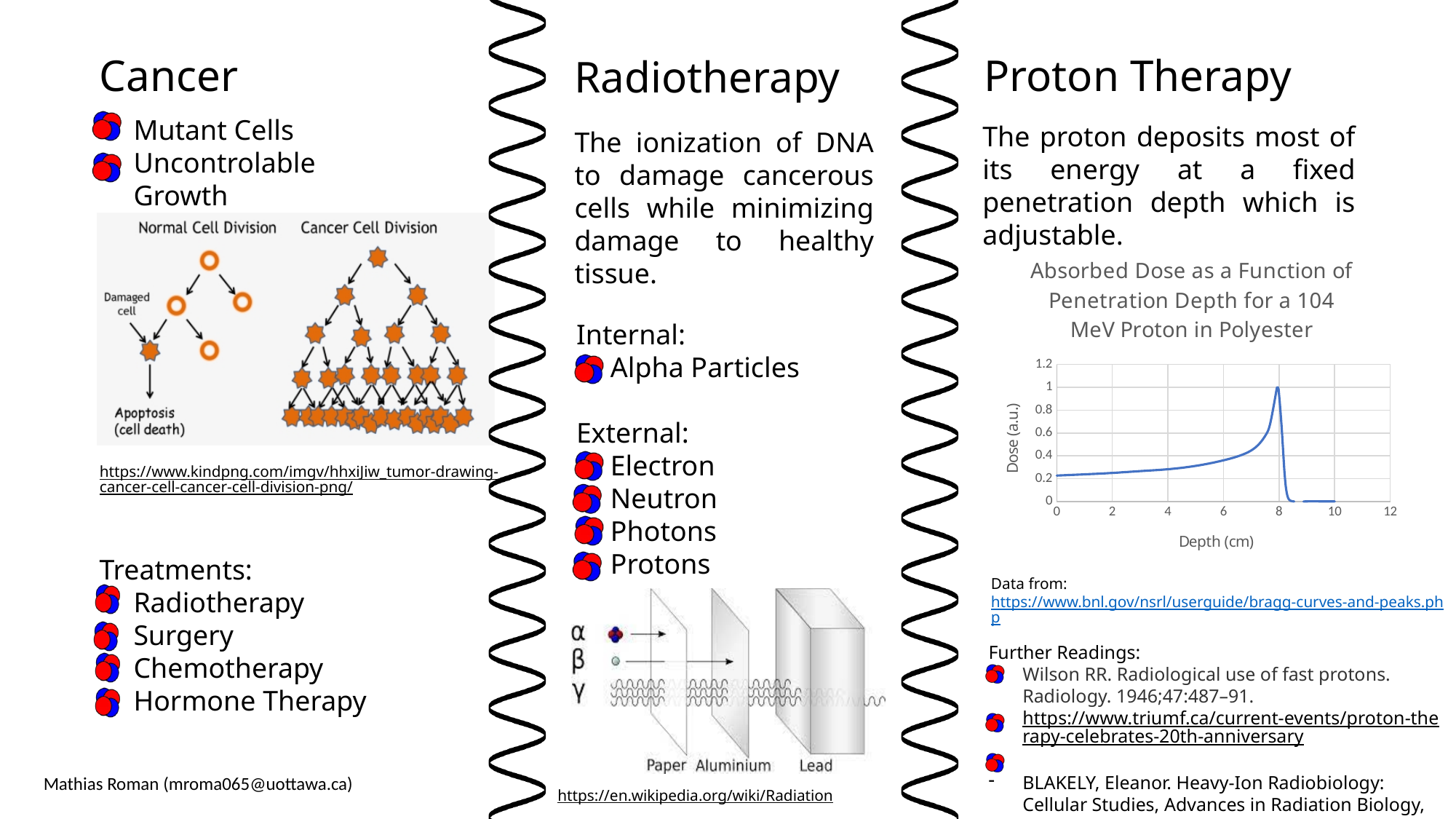
Is the dose at a depth of 10 cm greater or less than 0.2? less What is the highest value shown on the y axis of the chart? 1.2 Does the dose rise or fall as depth increases from 0 cm to 8 cm? rise What is the label of the x axis of the chart? Depth (cm) Is the peak dose on the chart greater or less than 0.8? greater Is the dose at a depth of 0 cm greater or less than 0.4? less Is the dose at a depth of 4 cm larger or smaller than the dose at a depth of 10 cm? larger Does the dose rise or fall as depth increases from 8 cm to 9 cm? fall What kind of chart is shown on the slide? line chart What is the title of the chart on the slide? Absorbed Dose as a Function of Penetration Depth for a 104 MeV Proton in Polyester